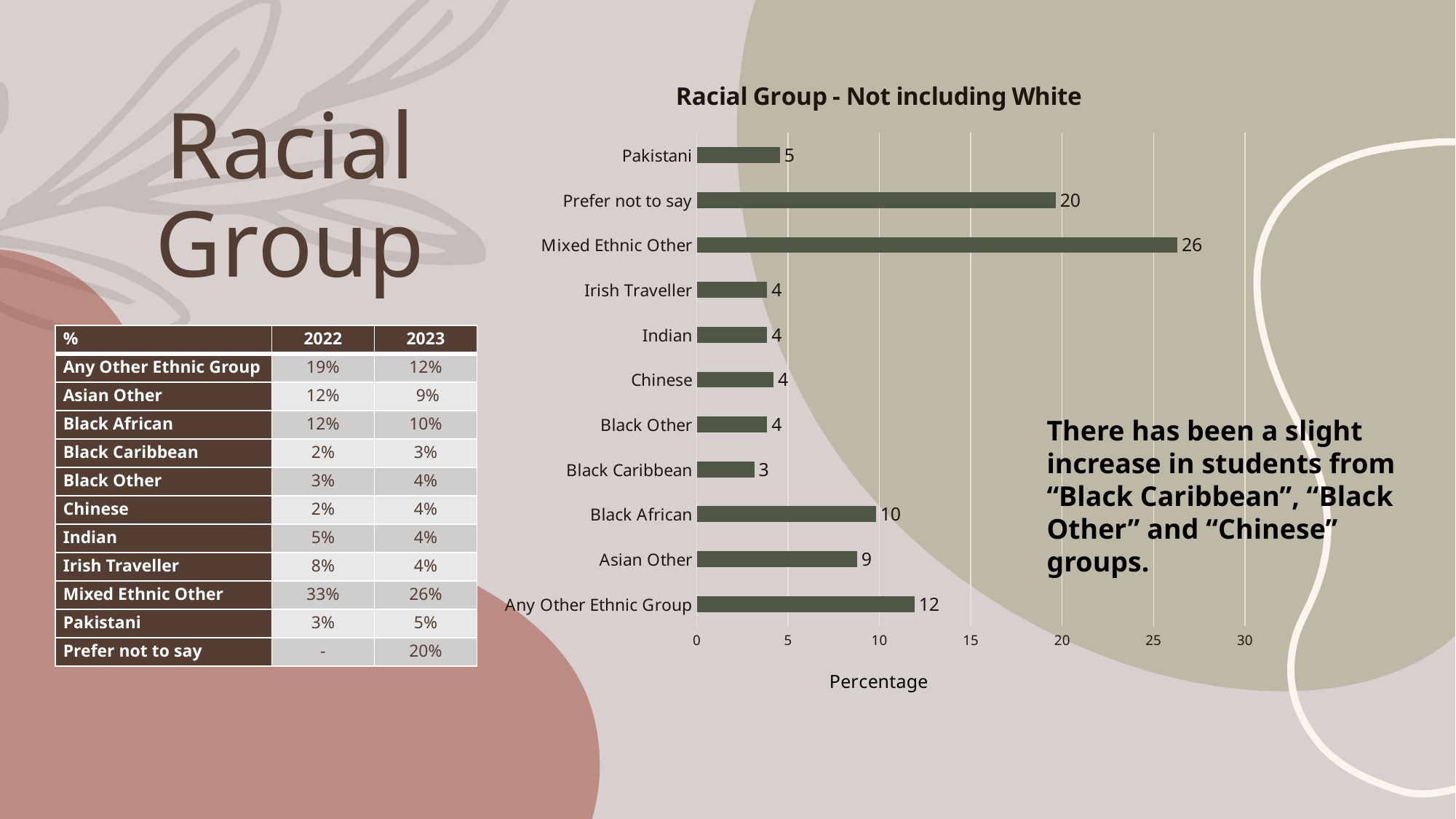
What is the label of the horizontal axis of the chart? Percentage What is the value for Mixed Ethnic Other in the chart? 26 Is the value for Prefer not to say greater or less than 15? greater What kind of chart is shown on the slide? bar chart Which category has the highest value in the chart? Mixed Ethnic Other How many categories are shown in the chart? 11 What is the title of the chart? Racial Group - Not including White What is the difference between the values for Mixed Ethnic Other and Prefer not to say? 6 Which category has the lowest value in the chart? Black Caribbean What is the value for Black African in the chart? 10 Which is larger, the value for Any Other Ethnic Group or the value for Asian Other? Any Other Ethnic Group What is the value for Prefer not to say in the chart? 20